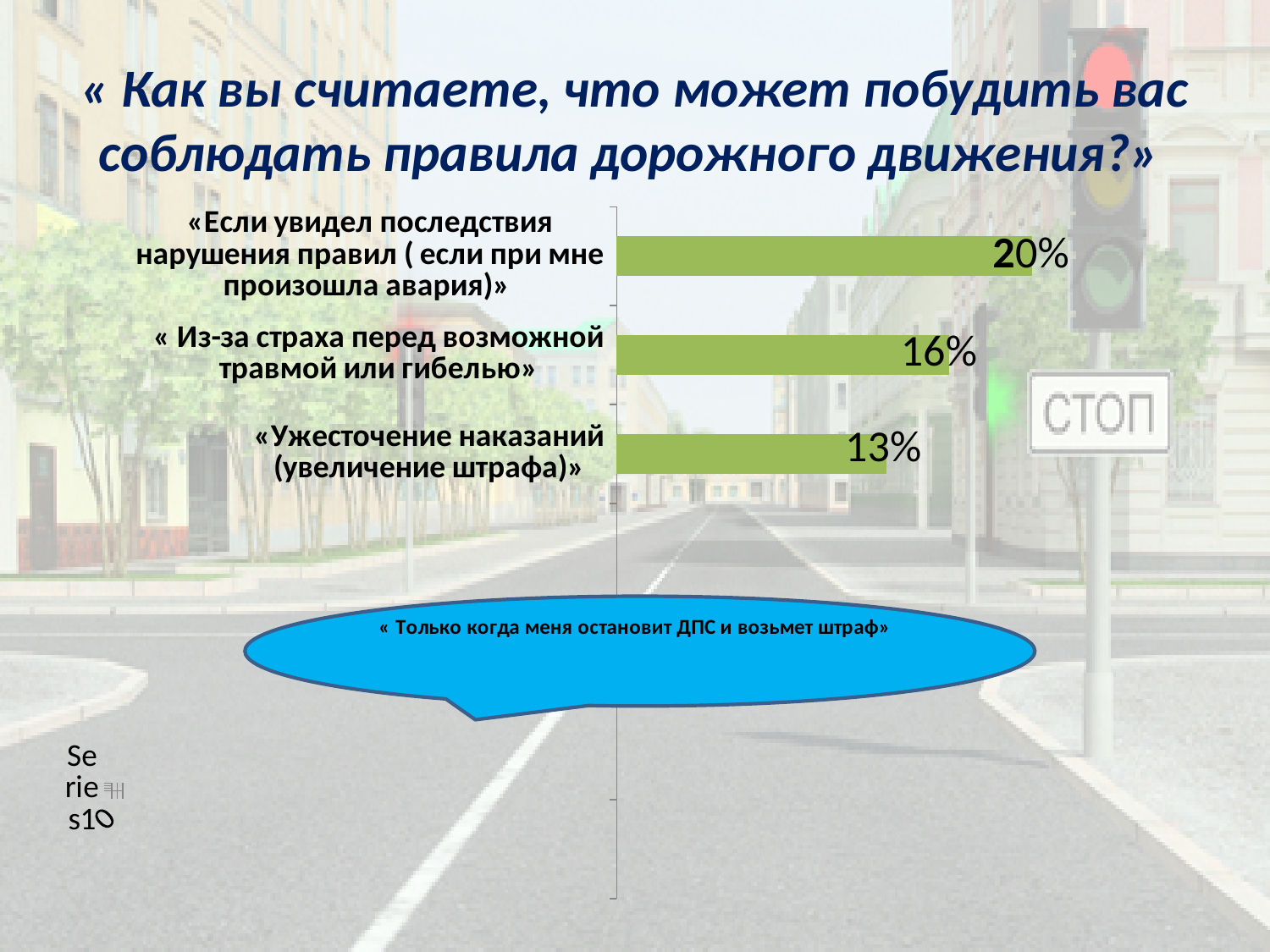
What is the difference between the values for «Если увидел последствия нарушения правил» and «Ужесточение наказаний (увеличение штрафа)»? 7% What kind of chart is shown on the slide? Bar chart What value is shown for « Из-за страха перед возможной травмой или гибелью»? 16% What colour are the bars in the chart? Green What value is shown for «Если увидел последствия нарушения правил ( если при мне произошла авария)»? 20% Which labelled category has the lowest value? «Ужесточение наказаний (увеличение штрафа)» Which labelled category has the highest value? «Если увидел последствия нарушения правил ( если при мне произошла авария)» Which is larger: the value for « Из-за страха перед возможной травмой или гибелью» or for «Ужесточение наказаний (увеличение штрафа)»? « Из-за страха перед возможной травмой или гибелью» What is the title of the slide above the chart? « Как вы считаете, что может побудить вас соблюдать правила дорожного движения?» What is the difference between the values for « Из-за страха перед возможной травмой или гибелью» and «Ужесточение наказаний (увеличение штрафа)»? 3% What value is shown for «Ужесточение наказаний (увеличение штрафа)»? 13%